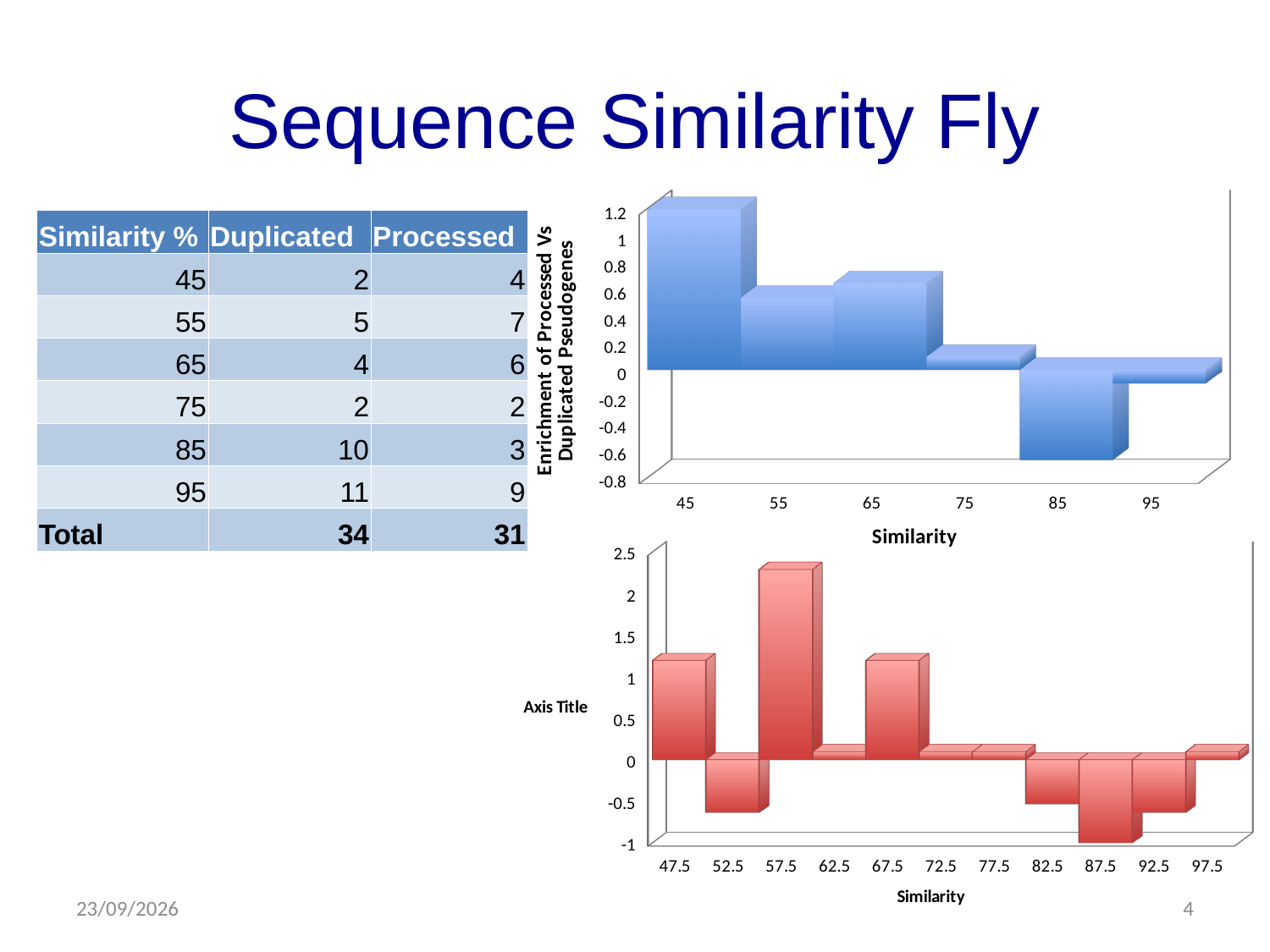
In the bottom chart, which Similarity category has the highest value? 57.5 In the top chart, which Similarity category has the highest value? 45 In the top chart, is the value for Similarity 85 greater or less than -0.4? less What is the x-axis title of the bottom chart? Similarity How many Similarity categories are plotted in the bottom chart? 11 In the top chart, is the value for Similarity 45 greater or less than 1? greater In the top chart, which Similarity category has the lowest value? 85 In the bottom chart, which Similarity category has the lowest value? 87.5 In the top chart, which has the larger value, Similarity 45 or Similarity 55? 45 How many Similarity categories are plotted in the top chart? 6 In the bottom chart, is the value for Similarity 57.5 greater or less than 2? greater What kind of chart is the top chart on the slide? bar chart